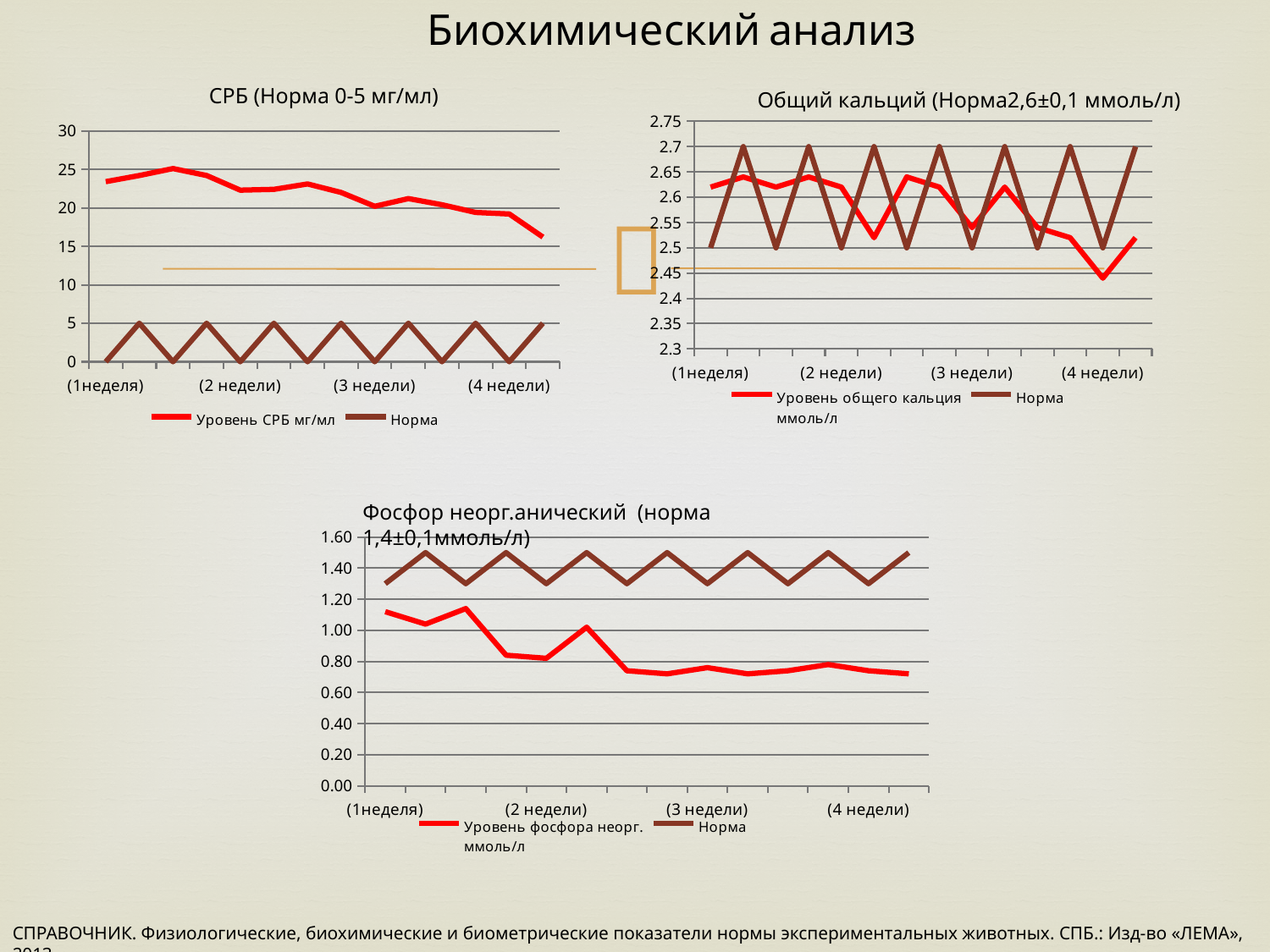
How many series does the legend of the "СРБ (Норма 0-5 мг/мл)" chart list? 2 In the "СРБ (Норма 0-5 мг/мл)" chart, is the first point of the "Уровень СРБ мг/мл" line greater or less than 20? greater In the "СРБ (Норма 0-5 мг/мл)" chart, is the last point of the "Уровень СРБ мг/мл" line greater or less than 20? less In the "Фосфор неорг.анический" chart, does the "Уровень фосфора неорг. ммоль/л" line rise or fall overall along the x axis? Fall In the "Общий кальций" chart, is the lowest point of the "Уровень общего кальция ммоль/л" line greater or less than 2.5? less How many week labels are shown on the x axis of the "СРБ (Норма 0-5 мг/мл)" chart? 4 In the "СРБ (Норма 0-5 мг/мл)" chart, does the "Уровень СРБ мг/мл" line rise or fall overall along the x axis? Fall How many series does the legend of the "Общий кальций" chart list? 2 What kind of chart is the "Фосфор неорг.анический" chart? Line chart What kind of chart is the "СРБ (Норма 0-5 мг/мл)" chart? Line chart In the "Фосфор неорг.анический" chart, at the first point, which line is higher: "Уровень фосфора неорг. ммоль/л" or "Норма"? Норма